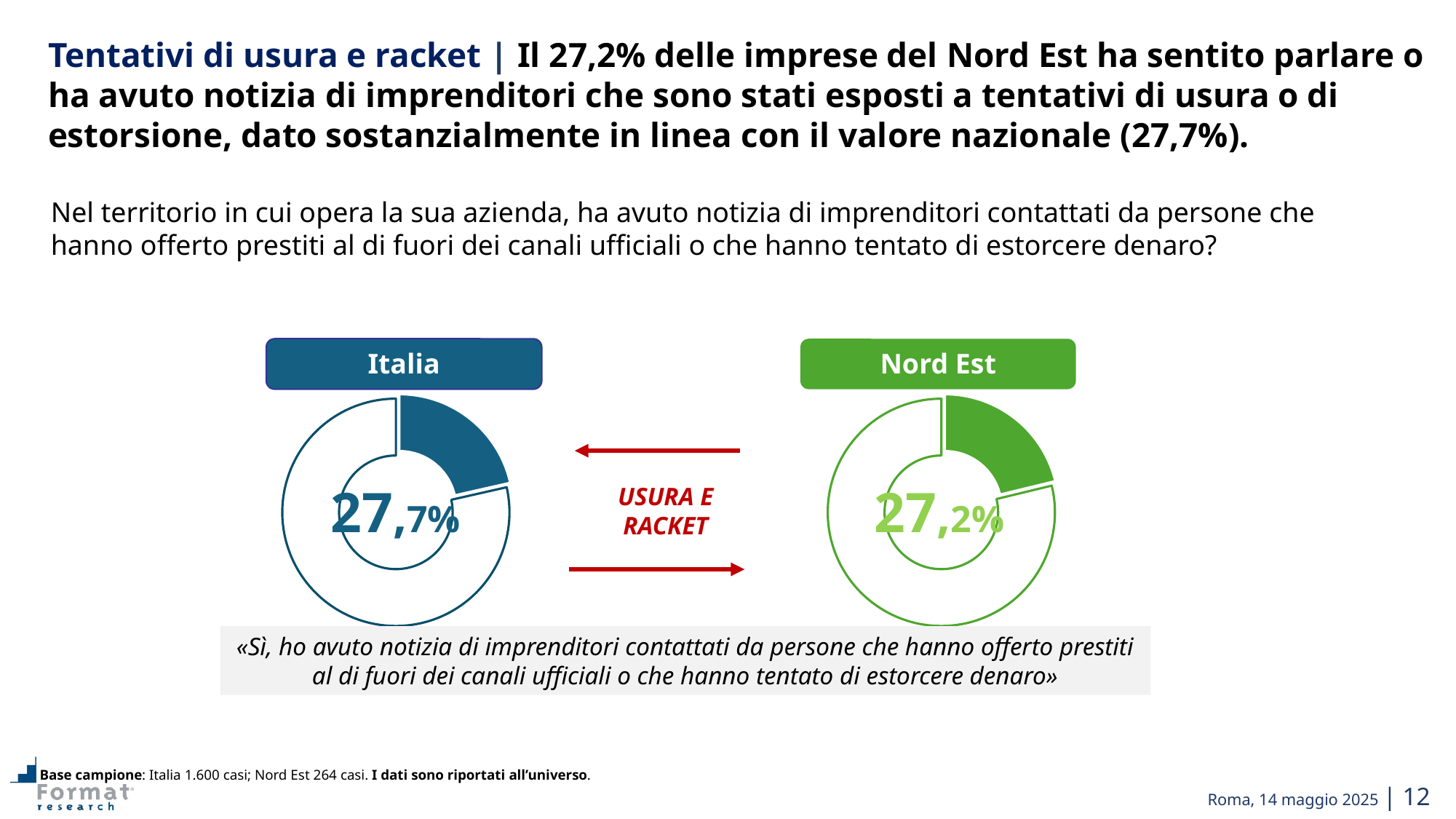
Is the value shown in the Italia chart greater or less than 25%? greater In the Nord Est chart, what percentage is shown in the centre of the donut? 27,2% What kind of chart is used to show the Italia value? Donut (pie) chart Is the value shown in the Nord Est chart greater or less than 30%? less Which chart, Italia or Nord Est, shows the lower percentage? Nord Est In the Italia chart, what percentage of firms reported having heard of entrepreneurs exposed to usury or extortion attempts? 27,7% What is the difference in percentage points between the Italia value and the Nord Est value? 0,5 How many donut charts are shown on the slide? 2 What label appears in red between the two donut charts? USURA E RACKET What colour is the highlighted slice in the Nord Est chart? Green Which of the two charts, Italia or Nord Est, shows the higher percentage? Italia